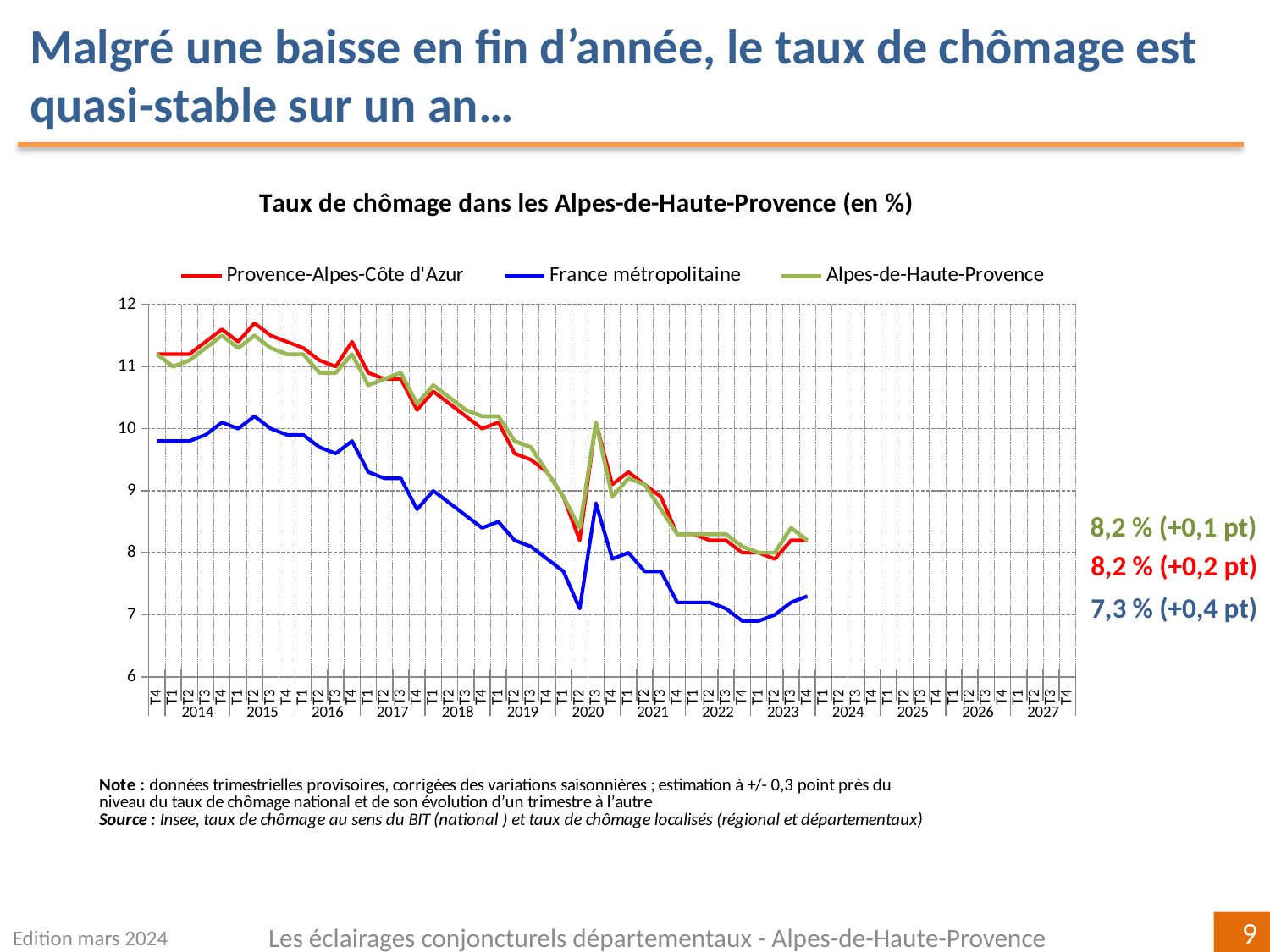
Which series is drawn in blue? France métropolitaine Is the value for France métropolitaine in T2 2020 greater or less than 8? less What kind of chart is shown on the slide? line chart What is the difference between the latest Provence-Alpes-Côte d'Azur rate and the latest France métropolitaine rate? 0,9 Overall, do the unemployment rates rise or fall from 2014 to 2023? fall At the end of the series, is the rate for Provence-Alpes-Côte d'Azur larger or smaller than the rate for France métropolitaine? larger What is the title of the chart? Taux de chômage dans les Alpes-de-Haute-Provence (en %) What is the latest unemployment rate shown for France métropolitaine? 7,3 % Which series has the lowest values throughout the period? France métropolitaine What is the latest unemployment rate shown for Alpes-de-Haute-Provence? 8,2 % By how many points did the France métropolitaine rate change according to the annotation? +0,4 pt How many series does the legend list? 3